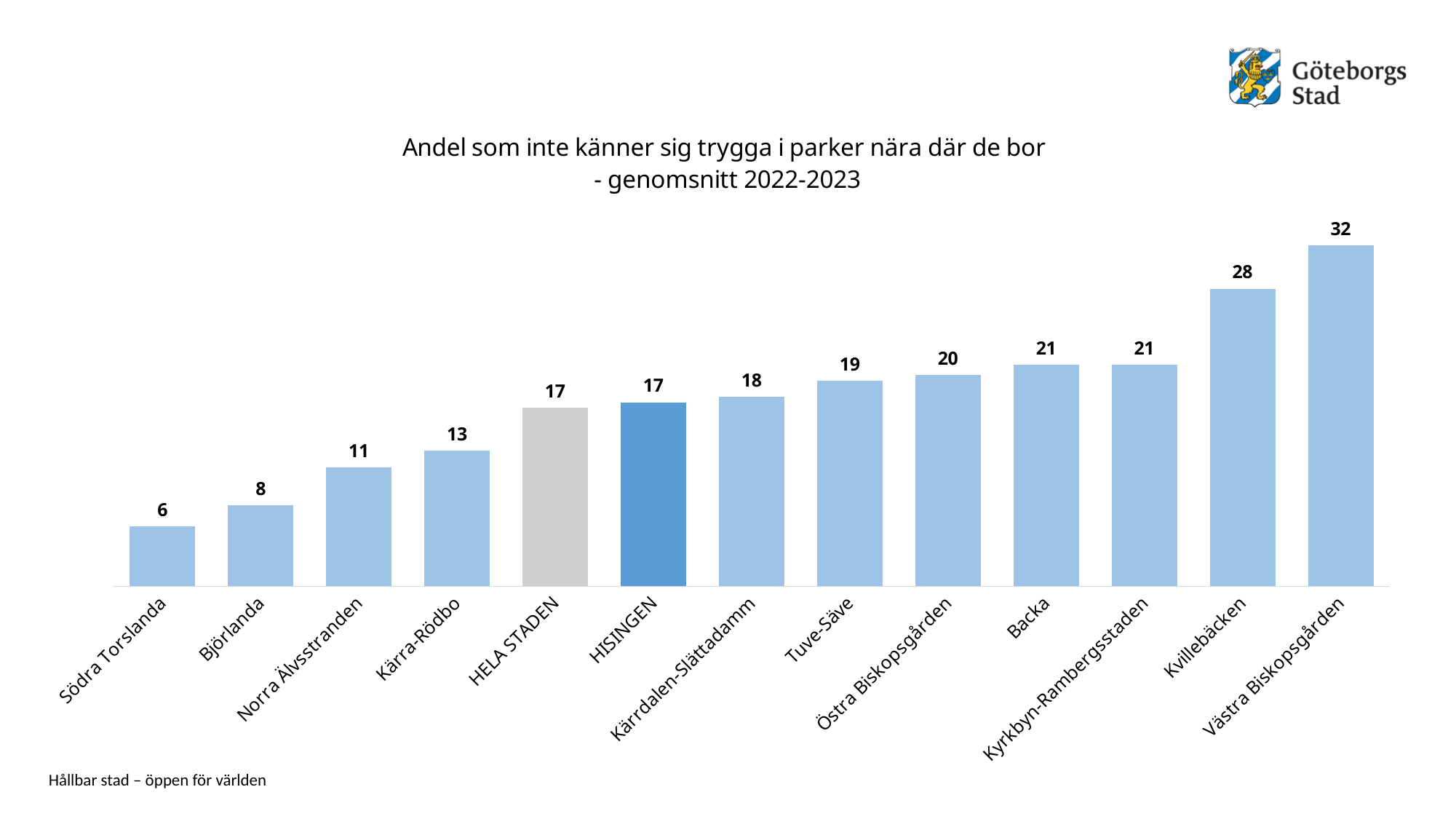
What is the difference between the values for Kärra-Rödbo and Björlanda? 5 What is the difference between the values for Västra Biskopsgården and Kvillebäcken? 4 Do the values rise or fall from left to right along the x axis? Rise What kind of chart is this? Bar chart What is the value for Kvillebäcken? 28 Which category has the lowest value? Södra Torslanda Which category has the highest value? Västra Biskopsgården Which is larger, the value for Backa or the value for Tuve-Säve? Backa What is the value for HISINGEN? 17 What is the value for Södra Torslanda? 6 Which bar is shown in grey rather than blue? HELA STADEN How many categories are shown on the x axis? 13